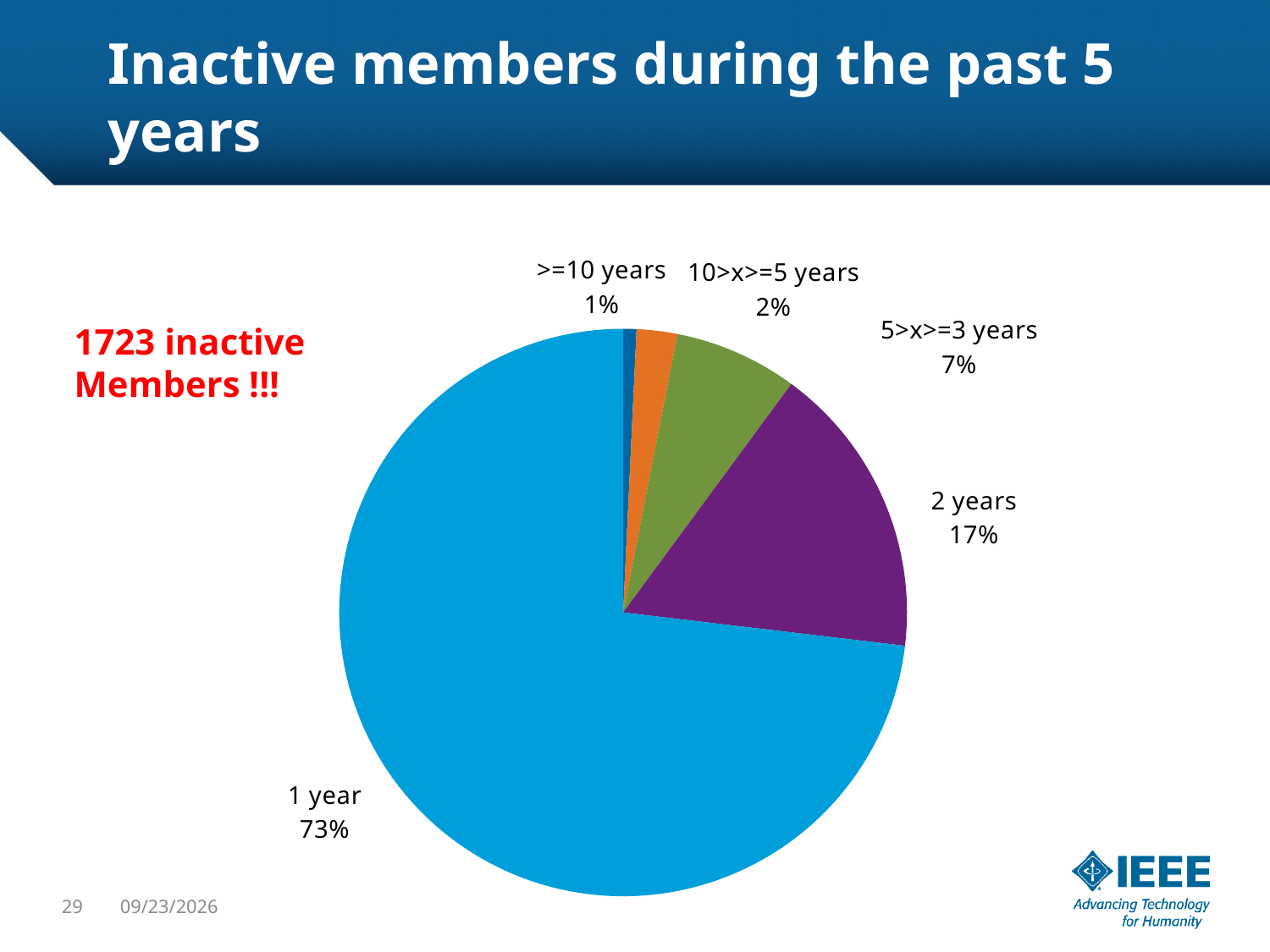
What percentage is shown for the "2 years" slice? 17% How many slices does the pie chart have? 5 What is the difference in percentage points between the "1 year" and "2 years" slices? 56 Which category has the smallest slice of the pie? >=10 years What percentage is shown for the "5>x>=3 years" slice? 7% What kind of chart is shown on the slide? Pie chart Which slice is larger, "5>x>=3 years" or "10>x>=5 years"? 5>x>=3 years Which category has the largest slice of the pie? 1 year What percentage is shown for the ">=10 years" slice? 1% According to the red text on the slide, how many inactive members are there? 1723 What share of the pie does the "1 year" slice represent? 73% What percentage is shown for the "10>x>=5 years" slice? 2%